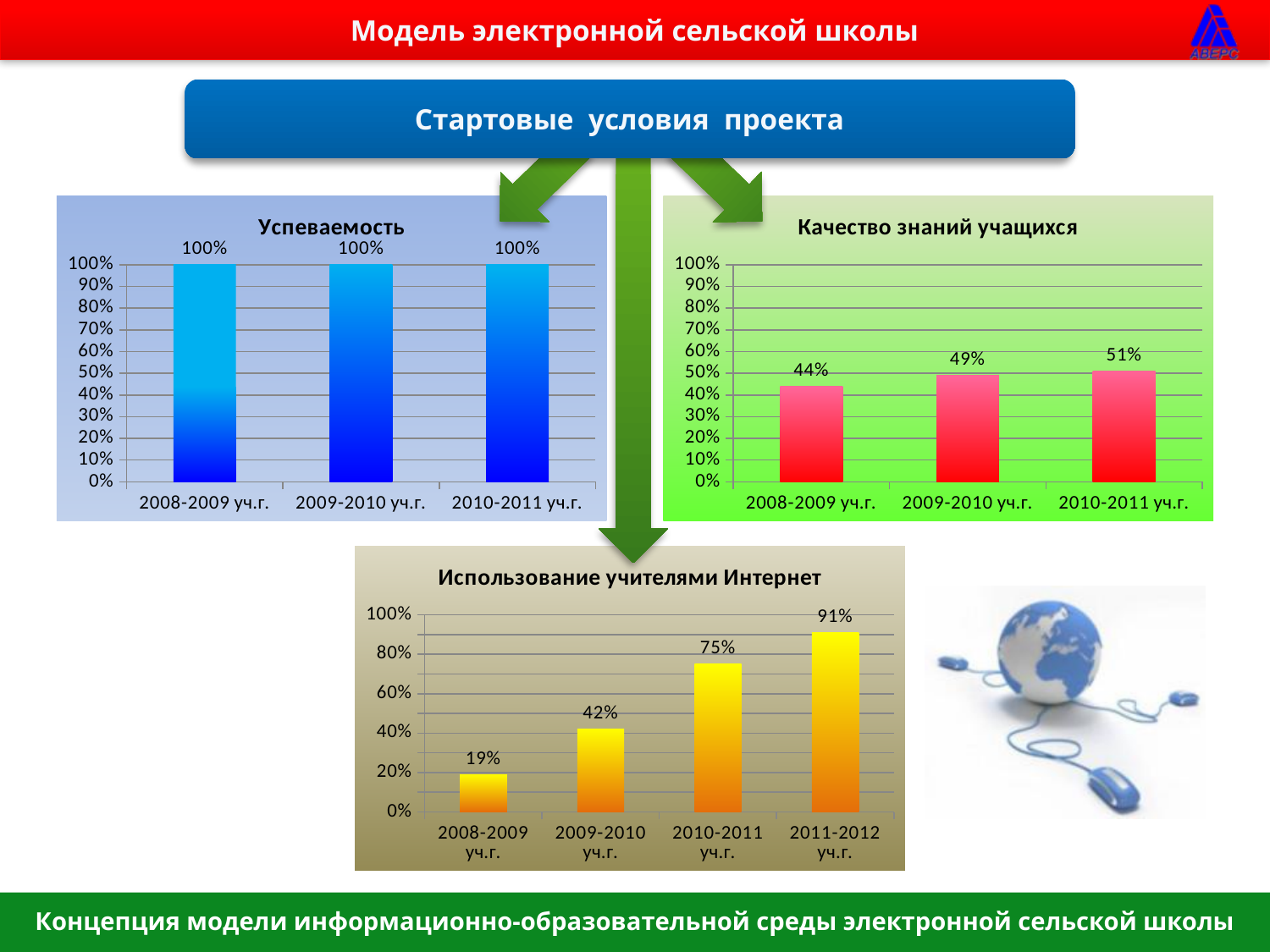
How many school years are shown in the chart titled "Использование учителями Интернет"? 4 In the chart titled "Качество знаний учащихся", what is the value for 2008-2009 уч.г.? 44% In the chart titled "Качество знаний учащихся", what is the difference between the values for 2009-2010 уч.г. and 2008-2009 уч.г.? 5% In the chart titled "Использование учителями Интернет", what is the value for 2011-2012 уч.г.? 91% In the chart titled "Использование учителями Интернет", what is the value for 2009-2010 уч.г.? 42% In the chart titled "Успеваемость", what is the value for 2009-2010 уч.г.? 100% In the chart titled "Качество знаний учащихся", what is the value for 2010-2011 уч.г.? 51% In the chart titled "Качество знаний учащихся", which school year has the highest value? 2010-2011 уч.г. In the chart titled "Использование учителями Интернет", what is the difference between the values for 2010-2011 уч.г. and 2009-2010 уч.г.? 33% In the chart titled "Использование учителями Интернет", do the values rise or fall from 2008-2009 уч.г. to 2011-2012 уч.г.? rise In the chart titled "Использование учителями Интернет", which is larger: the value for 2010-2011 уч.г. or 2009-2010 уч.г.? 2010-2011 уч.г. In the chart titled "Использование учителями Интернет", which school year has the lowest value? 2008-2009 уч.г.